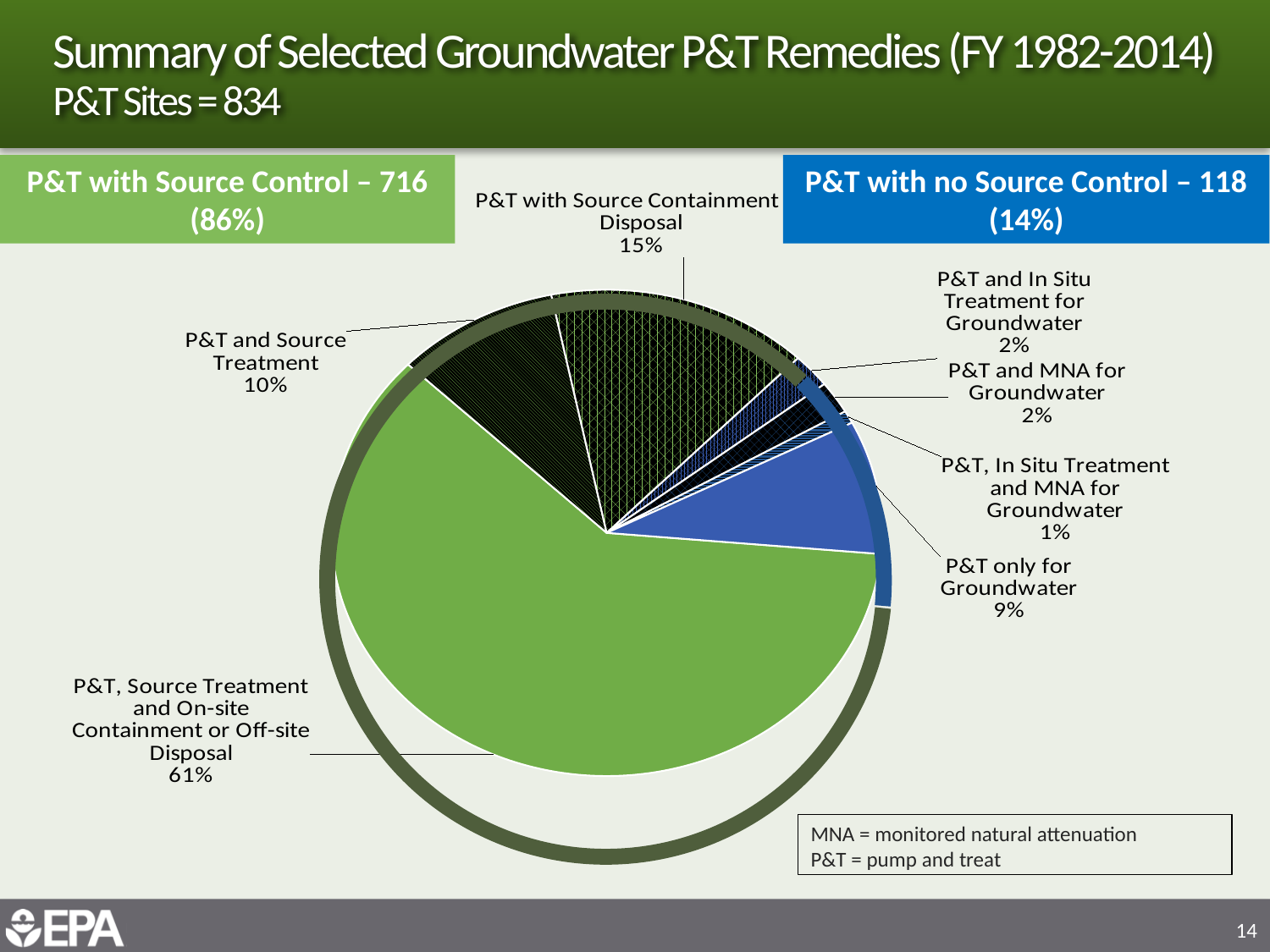
What percentage is shown for 'P&T, In Situ Treatment and MNA for Groundwater'? 1% What percentage is shown for 'P&T with Source Containment Disposal'? 15% Which is larger: 'P&T with Source Containment Disposal' or 'P&T and Source Treatment'? P&T with Source Containment Disposal Which slice of the pie is the smallest? P&T, In Situ Treatment and MNA for Groundwater What percentage of the pie is 'P&T, Source Treatment and On-site Containment or Off-site Disposal'? 61% What is the total number of P&T sites stated in the slide title? 834 What is the difference in percentage points between 'P&T, Source Treatment and On-site Containment or Off-site Disposal' and 'P&T with Source Containment Disposal'? 46 percentage points Which slice of the pie is the largest? P&T, Source Treatment and On-site Containment or Off-site Disposal How many slices does the pie chart have? 7 What kind of chart is shown on the slide? Pie chart How many P&T sites with Source Control are reported on the slide, and what share is that? 716 (86%) What percentage is shown for 'P&T only for Groundwater'? 9%